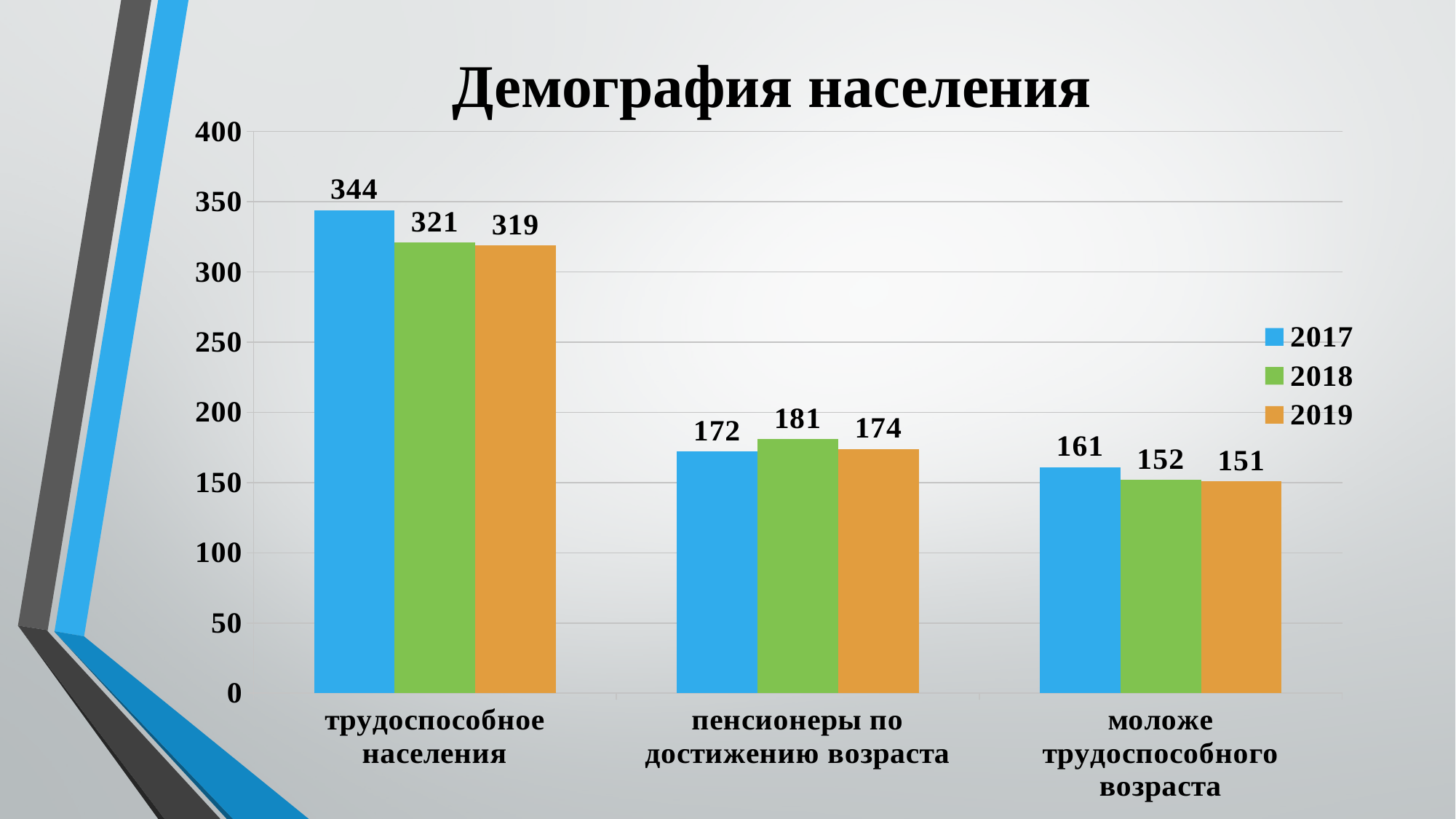
How many categories are shown on the x axis? 3 What is the difference between the 2017 and 2019 values for трудоспособное населения? 25 How many series does the legend list? 3 Which category has the lowest value in the 2019 series? моложе трудоспособного возраста Which is larger for пенсионеры по достижению возраста: the 2017 value or the 2018 value? 2018 What kind of chart is shown on the slide? bar chart What is the value for пенсионеры по достижению возраста in 2018? 181 Is the 2018 value for моложе трудоспособного возраста greater or less than 200? less What is the title of the chart? Демография населения Which category has the highest value in the 2017 series? трудоспособное населения What is the value for моложе трудоспособного возраста in 2019? 151 What is the value for трудоспособное населения in 2017? 344